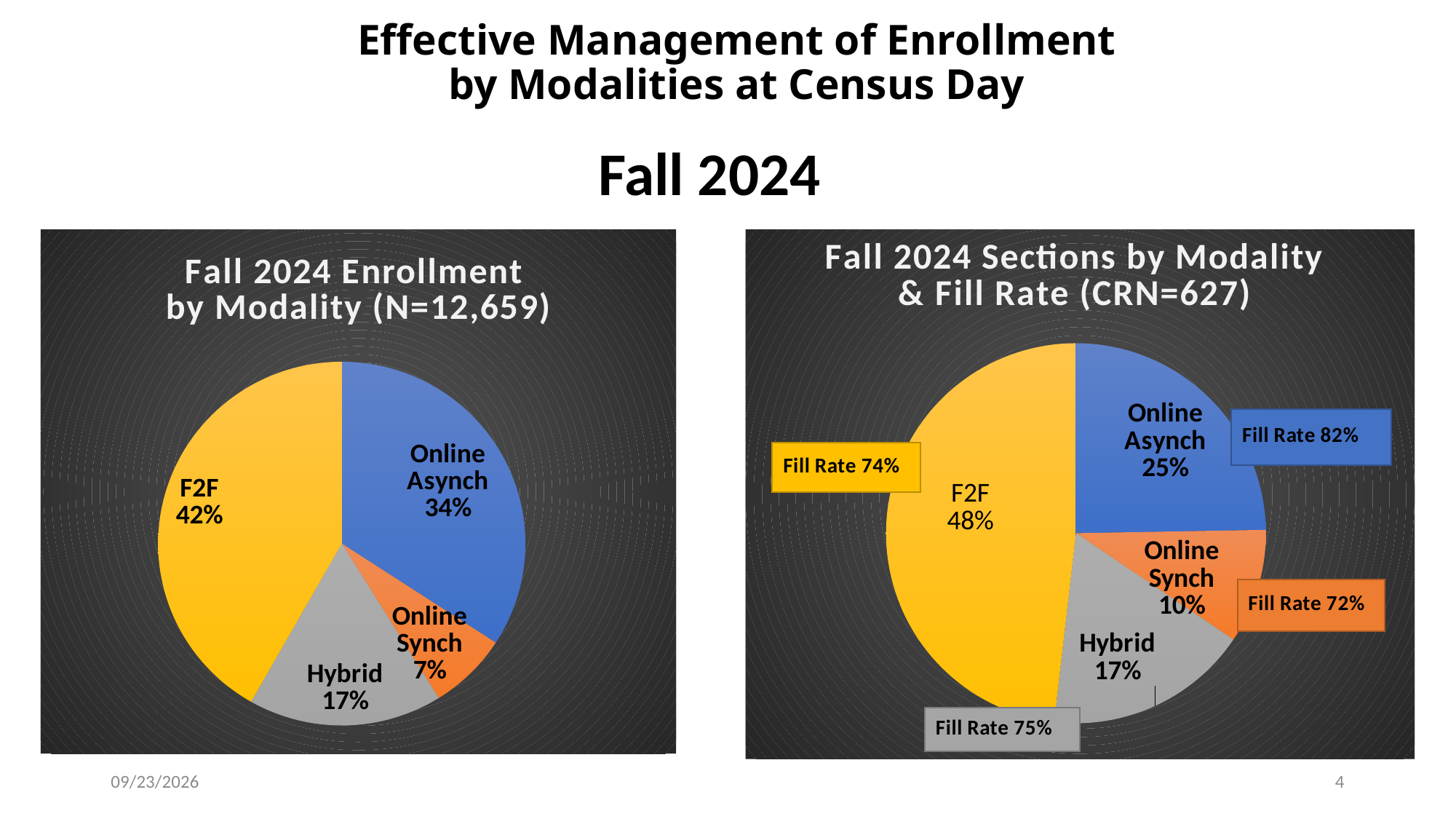
What is the total enrollment (N) stated in the title of the left chart? 12,659 In the 'Fall 2024 Sections by Modality & Fill Rate' chart, what share of sections is F2F? 48% In the 'Fall 2024 Enrollment by Modality' chart, what share of enrollment is F2F? 42% In the 'Fall 2024 Enrollment by Modality' chart, which modality has the largest share? F2F In the 'Fall 2024 Enrollment by Modality' chart, what share of enrollment is Online Asynch? 34% In the 'Fall 2024 Sections by Modality & Fill Rate' chart, what is the fill rate for Hybrid? 75% In the 'Fall 2024 Enrollment by Modality' chart, how many modalities are shown? 4 In the 'Fall 2024 Sections by Modality & Fill Rate' chart, what is the fill rate for Online Asynch? 82% In the 'Fall 2024 Sections by Modality & Fill Rate' chart, what is the difference between the F2F share and the Online Asynch share of sections? 23% In the 'Fall 2024 Enrollment by Modality' chart, which modality has the smallest share? Online Synch In the 'Fall 2024 Sections by Modality & Fill Rate' chart, which modality has the lowest fill rate? Online Synch What kind of chart is the 'Fall 2024 Enrollment by Modality' chart? Pie chart